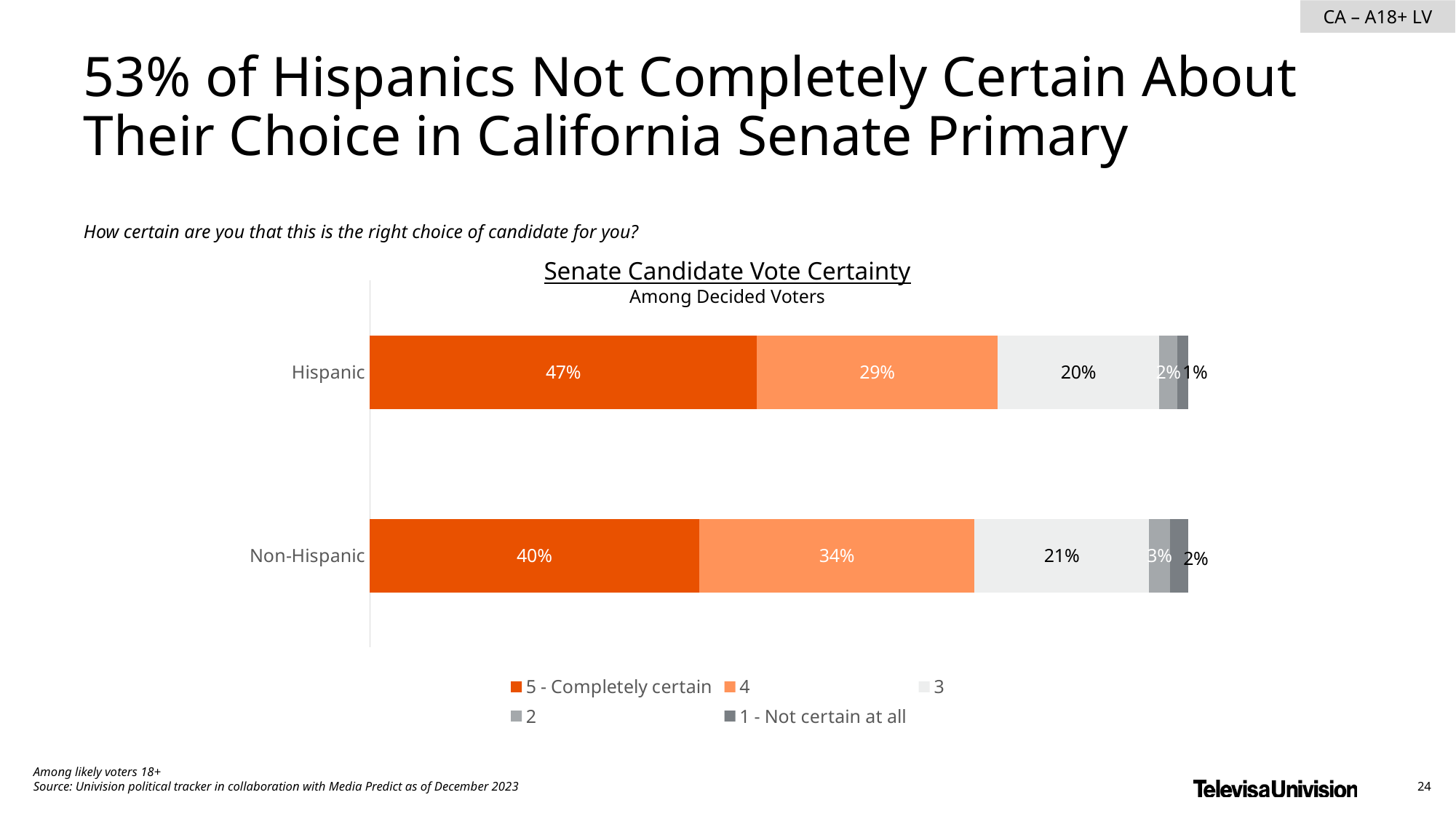
How many groups (categories) are shown on the chart? 2 What percentage of Hispanic decided voters are '1 - Not certain at all'? 1% How many series does the legend list? 5 What percentage of Hispanic decided voters are '5 - Completely certain' about their Senate candidate choice? 47% Which legend entry is shown in the darkest orange colour? 5 - Completely certain What is the title of the chart? Senate Candidate Vote Certainty What percentage of Non-Hispanic decided voters rated their certainty as '4'? 34% What is the difference between the Non-Hispanic and Hispanic shares of voters rating their certainty as '4'? 5 percentage points What type of chart is shown on the slide? Stacked bar chart What percentage of Non-Hispanic decided voters rated their certainty as '3'? 21% Which group has the higher share of '5 - Completely certain' voters, Hispanic or Non-Hispanic? Hispanic What is the difference between the Hispanic and Non-Hispanic shares of '5 - Completely certain' voters? 7 percentage points